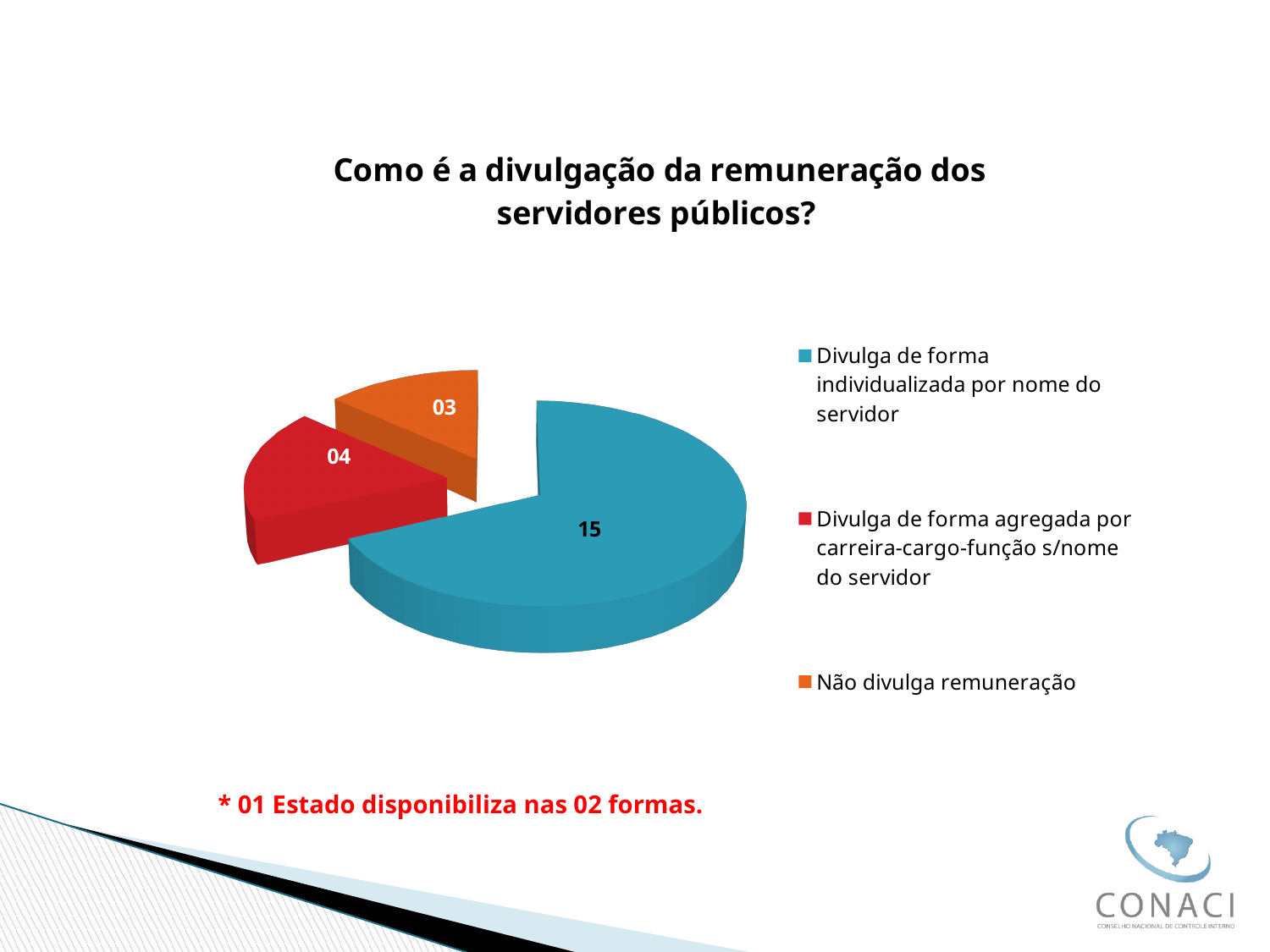
What is the value for 'Divulga de forma agregada por carreira-cargo-função s/nome do servidor'? 04 Which is larger: the value for 'Divulga de forma agregada por carreira-cargo-função s/nome do servidor' or the value for 'Não divulga remuneração'? Divulga de forma agregada por carreira-cargo-função s/nome do servidor What fraction of the total does the 'Divulga de forma individualizada por nome do servidor' slice represent? 15/22 What is the value for 'Não divulga remuneração'? 03 What type of chart is shown on the slide? Pie chart What is the value for 'Divulga de forma individualizada por nome do servidor'? 15 Which category has the smallest slice of the pie? Não divulga remuneração What is the total of all the slices in the pie chart? 22 What is the difference between the value for 'Divulga de forma individualizada por nome do servidor' and the value for 'Não divulga remuneração'? 12 How many categories does the pie chart have? 3 Which category has the largest slice of the pie? Divulga de forma individualizada por nome do servidor What colour is the slice for 'Não divulga remuneração'? Orange